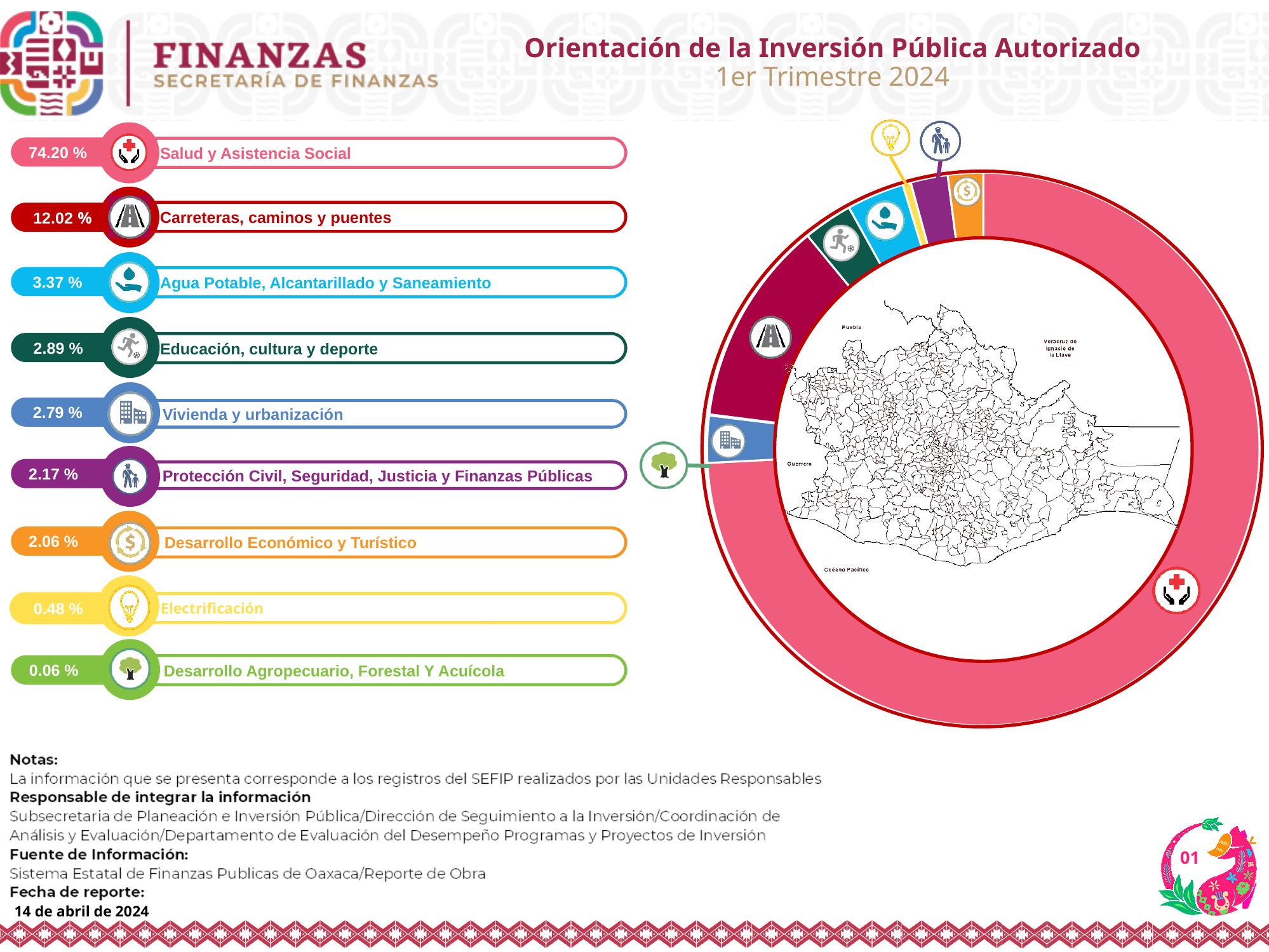
Which category has the smallest share of the authorized public investment? Desarrollo Agropecuario, Forestal Y Acuícola What percentage is shown for Agua Potable, Alcantarillado y Saneamiento? 3.37 % How many percentage points larger is the share for Salud y Asistencia Social than for Carreteras, caminos y puentes? 62.18 % What percentage is shown for Carreteras, caminos y puentes? 12.02 % How many categories are shown in the chart? 9 Which has a larger share: Desarrollo Económico y Turístico or Electrificación? Desarrollo Económico y Turístico What kind of chart is used to show the distribution of the authorized public investment? Donut (pie) chart Which category has the largest share of the authorized public investment? Salud y Asistencia Social What share of the authorized public investment goes to Salud y Asistencia Social? 74.20 % What is the difference between the shares for Agua Potable, Alcantarillado y Saneamiento and Educación, cultura y deporte? 0.48 % What is the title of the slide containing the chart? Orientación de la Inversión Pública Autorizado 1er Trimestre 2024 What percentage is shown for Protección Civil, Seguridad, Justicia y Finanzas Públicas? 2.17 %